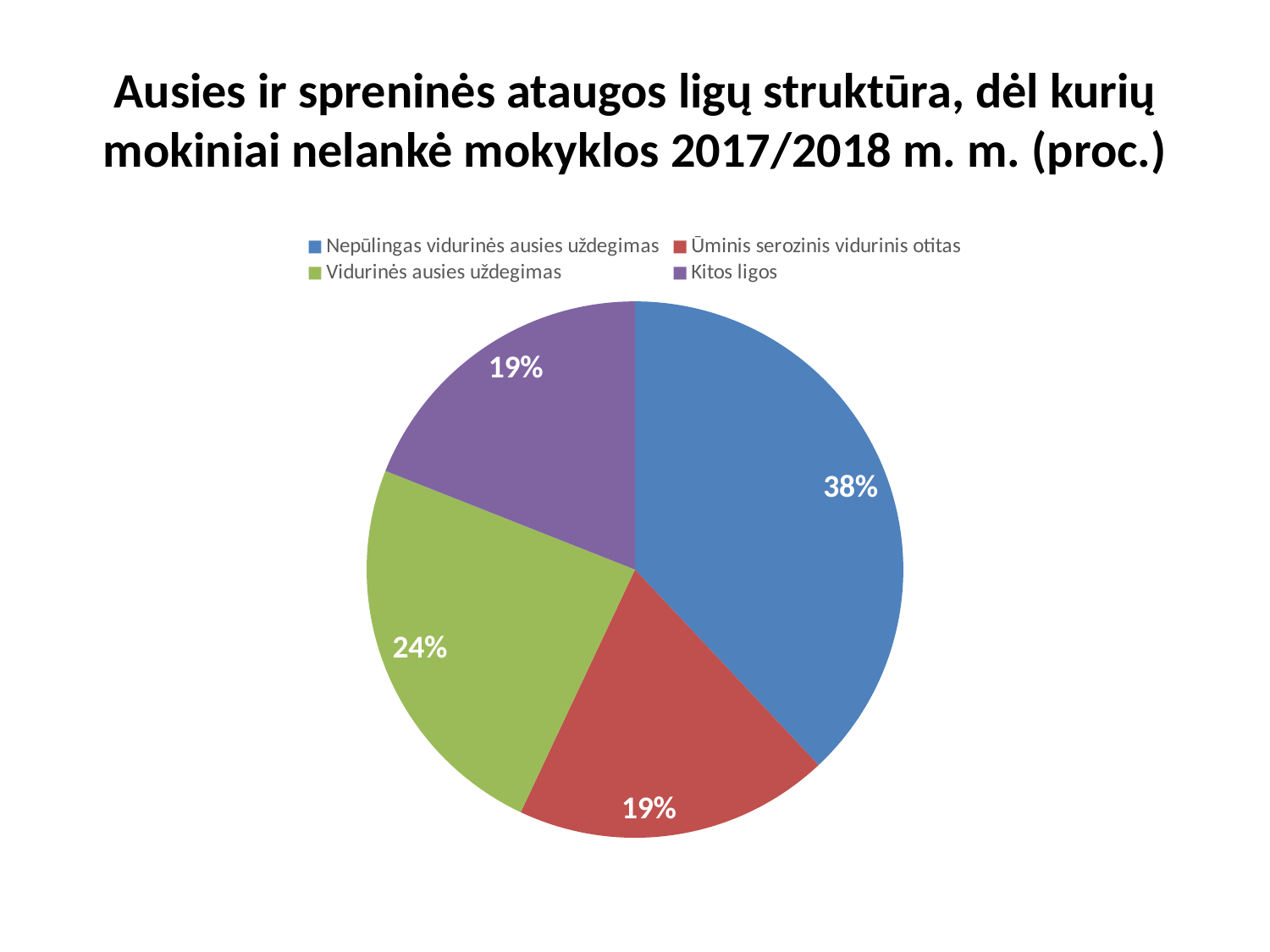
Which school year does the chart title refer to? 2017/2018 m. m. What kind of chart is shown on the slide? pie chart What share of the pie does Ūminis serozinis vidurinis otitas have? 19% What share of the pie does Nepūlingas vidurinės ausies uždegimas have? 38% What colour is the slice for Kitos ligos? purple Which is larger, the slice for Vidurinės ausies uždegimas or the slice for Kitos ligos? Vidurinės ausies uždegimas How many slices does the pie chart have? 4 What share of the pie does Kitos ligos have? 19% How many entries does the legend list? 4 What is the difference in percentage points between Nepūlingas vidurinės ausies uždegimas and Vidurinės ausies uždegimas? 14 Which category has the largest slice of the pie? Nepūlingas vidurinės ausies uždegimas